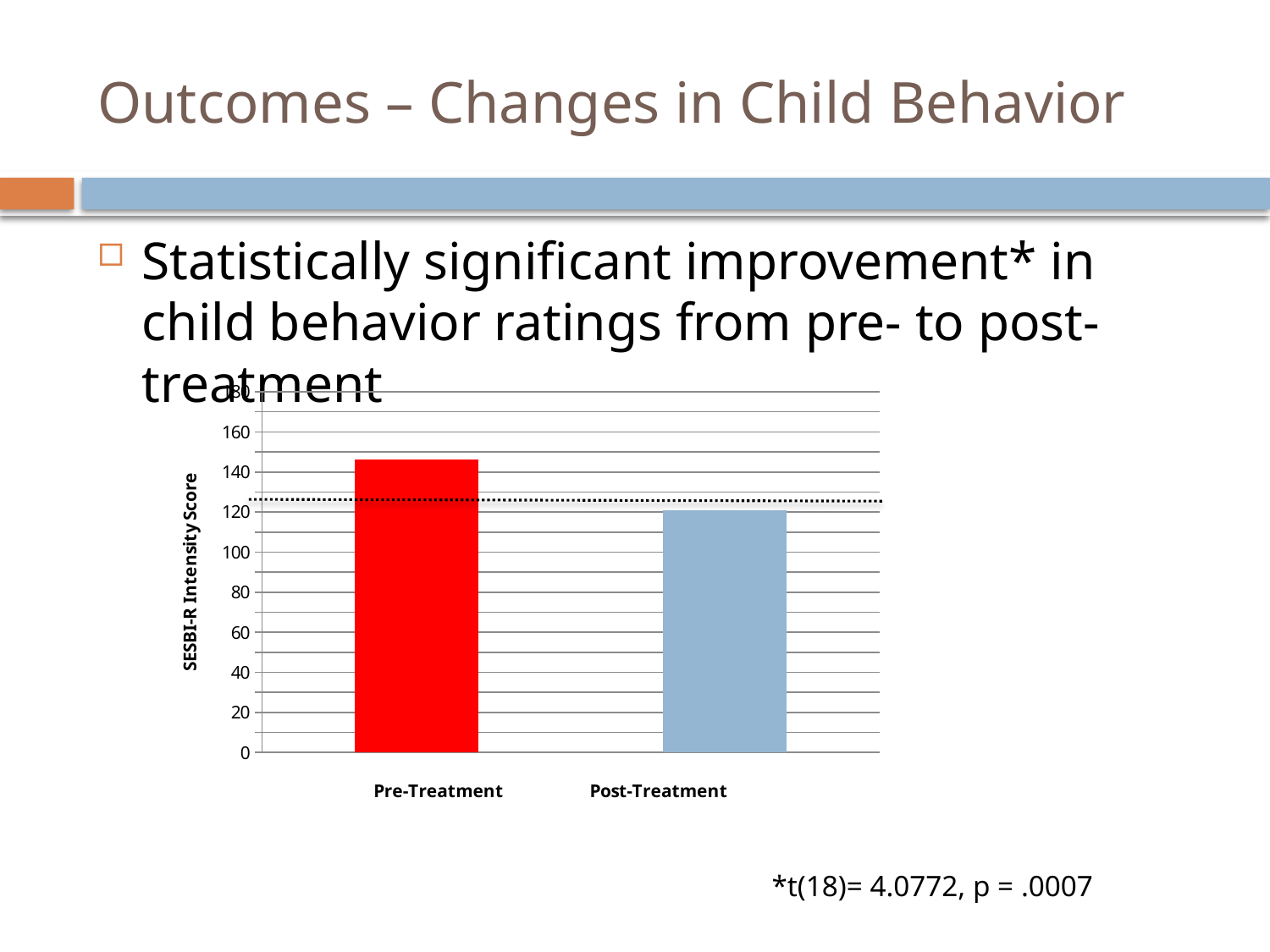
Which category has the lowest SESBI-R Intensity Score? Post-Treatment Which category has the highest SESBI-R Intensity Score? Pre-Treatment Do the values rise or fall from Pre-Treatment to Post-Treatment? fall Which is larger, the Pre-Treatment bar or the Post-Treatment bar? Pre-Treatment What is the label on the vertical axis of the chart? SESBI-R Intensity Score Is the value for Post-Treatment greater or less than 100? greater What colour is the Pre-Treatment bar? red Is the value for Pre-Treatment greater or less than 160? less How many bars (categories) are plotted in the chart? 2 What kind of chart is shown on the slide? bar chart Is the value for Post-Treatment greater or less than 140? less